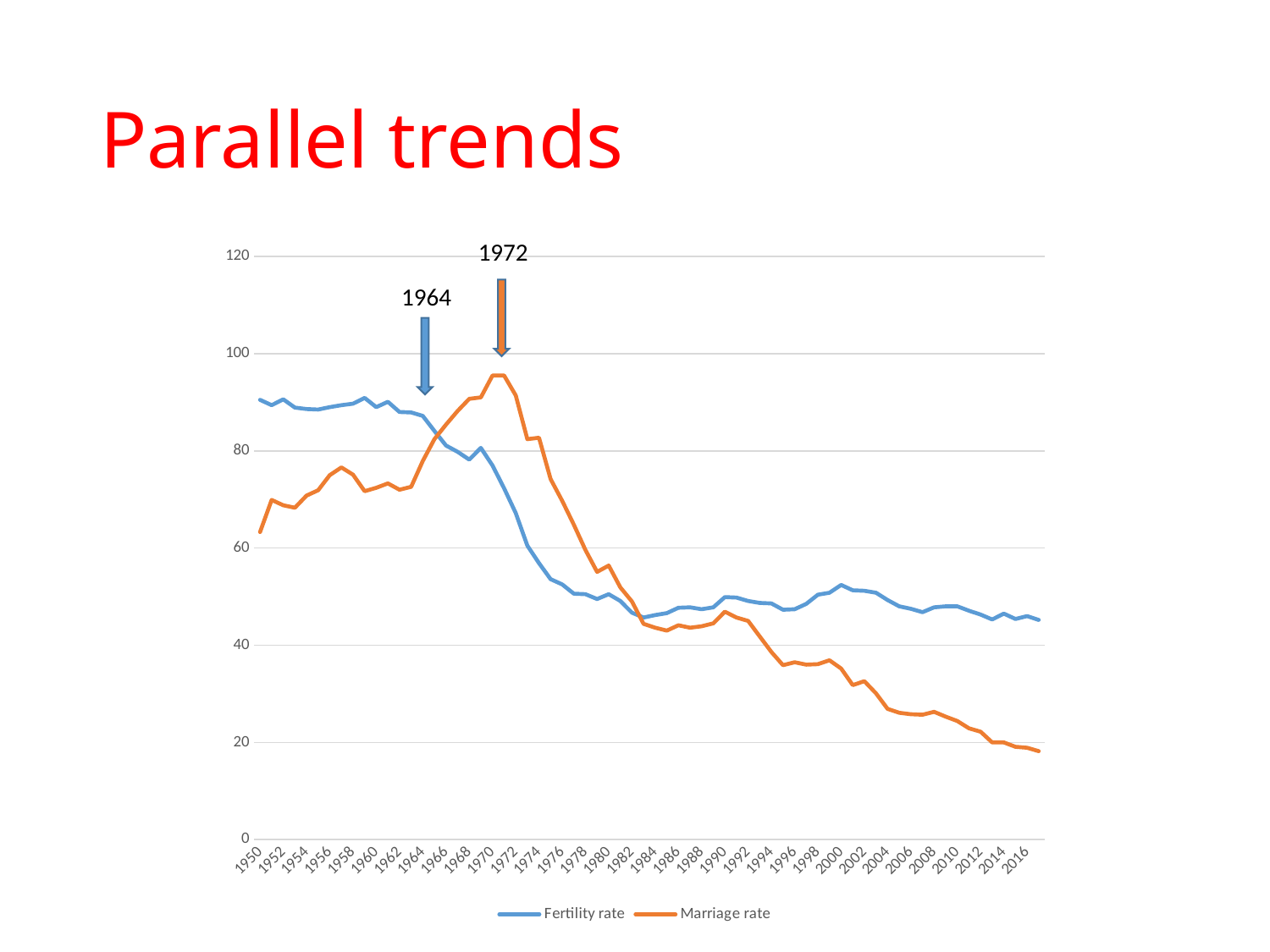
Is the Marriage rate value in 2016 greater or less than 40? less What kind of chart is shown on the slide? line chart How many series does the legend list? 2 Is the Fertility rate value in 1950 greater or less than 80? greater Is the Marriage rate value in 1950 greater or less than 80? less In 1972, which series has the higher value, Fertility rate or Marriage rate? Marriage rate Which year is marked by the blue arrow annotation above the lines? 1964 Does the Marriage rate rise or fall between 1972 and 2016? fall What are the two series named in the legend? Fertility rate and Marriage rate In 2016, which series has the higher value, Fertility rate or Marriage rate? Fertility rate In 1950, which series has the higher value, Fertility rate or Marriage rate? Fertility rate